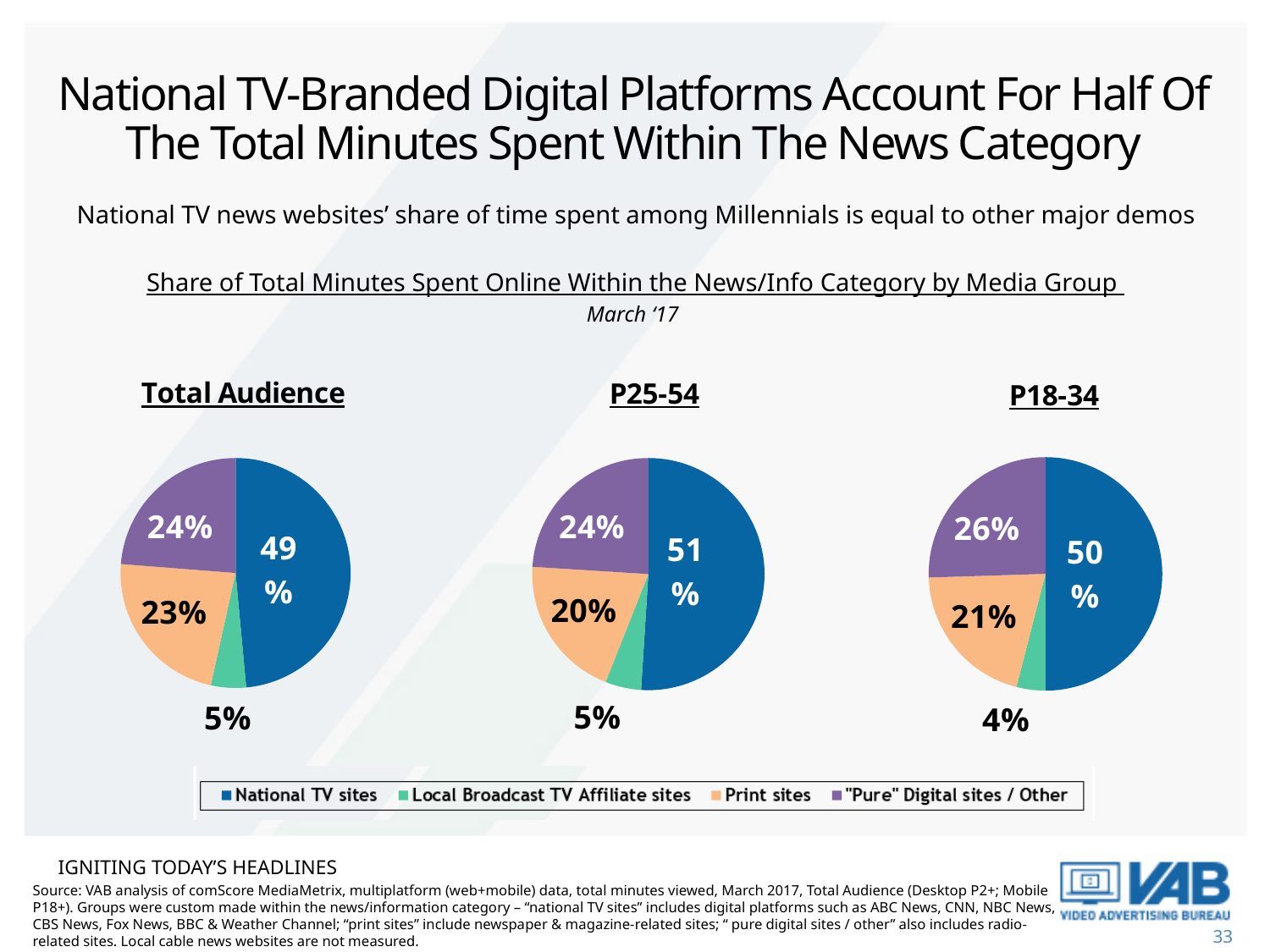
In the P18-34 pie chart, what share do Local Broadcast TV Affiliate sites have? 4% How many slices does the P25-54 pie chart have? 4 In the P25-54 pie chart, which media group has the largest share? National TV sites In the Total Audience pie chart, which is larger: the share for Print sites or the share for "Pure" Digital sites / Other? "Pure" Digital sites / Other In the P18-34 pie chart, what is the difference between the National TV sites share and the Print sites share? 29% How many media groups does the legend list? 4 In the P18-34 pie chart, what share do "Pure" Digital sites / Other have? 26% In the P25-54 pie chart, what share do Print sites have? 20% What type of chart is used to show the share of total minutes for each audience group? Pie chart In the Total Audience pie chart, which media group has the smallest share? Local Broadcast TV Affiliate sites How many pie charts are shown on the slide? 3 In the Total Audience pie chart, what share do National TV sites have? 49%